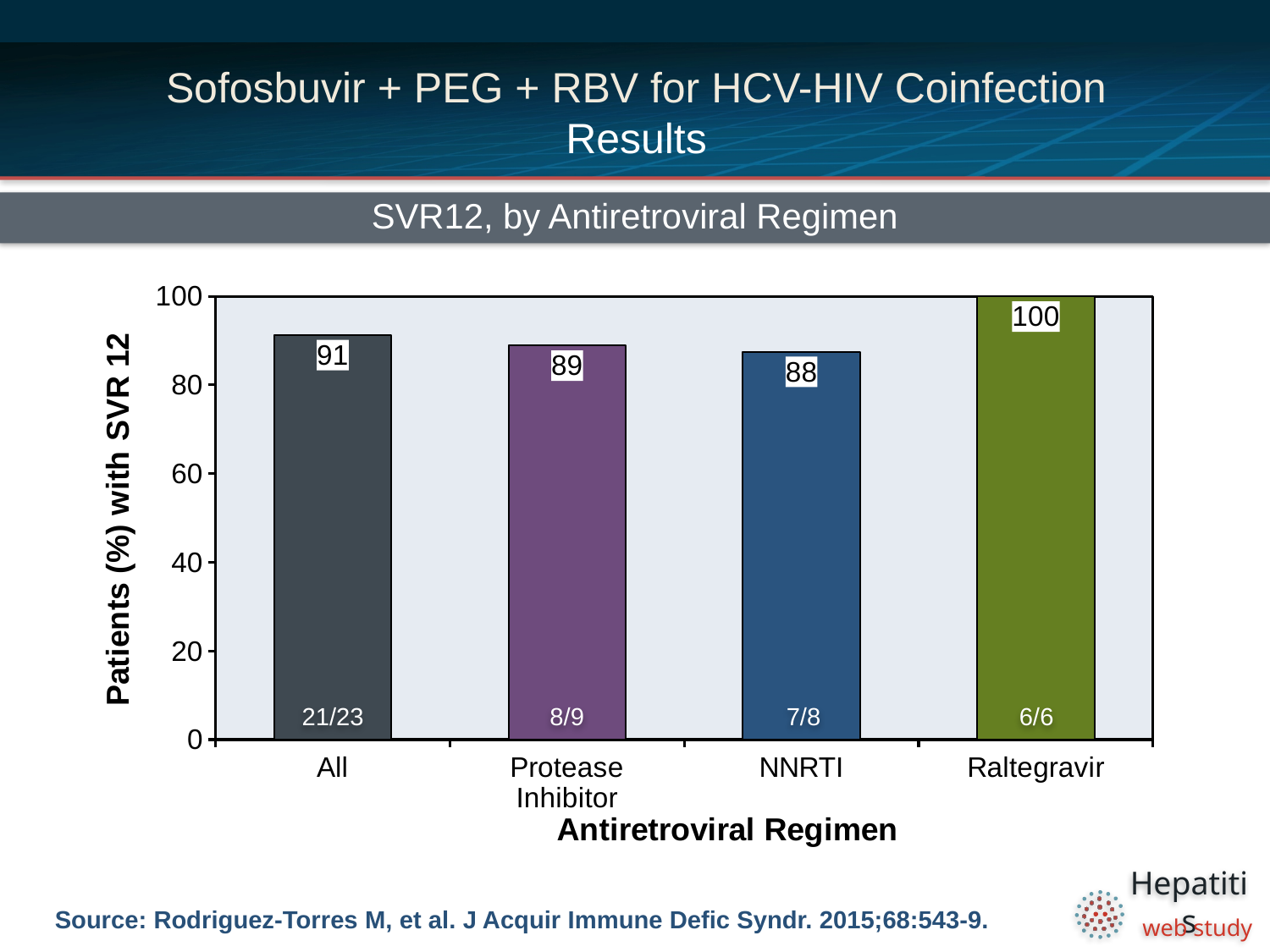
What fraction of patients achieved SVR12 in the Raltegravir group? 6/6 Which antiretroviral regimen has the lowest SVR12 rate? NNRTI Which antiretroviral regimen has the highest SVR12 rate? Raltegravir What is the SVR12 rate (%) for patients on a Protease Inhibitor regimen? 89 What type of chart is used to show SVR12 by antiretroviral regimen? Bar chart How many antiretroviral regimen categories are shown on the chart? 4 What is the SVR12 rate (%) for the All group? 91 What is the SVR12 rate (%) for the NNRTI group? 88 What is the label of the y-axis? Patients (%) with SVR 12 What is the difference in SVR12 rate (percentage points) between Raltegravir and NNRTI? 12 What is the title of the chart? SVR12, by Antiretroviral Regimen Which has a higher SVR12 rate, the All group or the Protease Inhibitor group? All